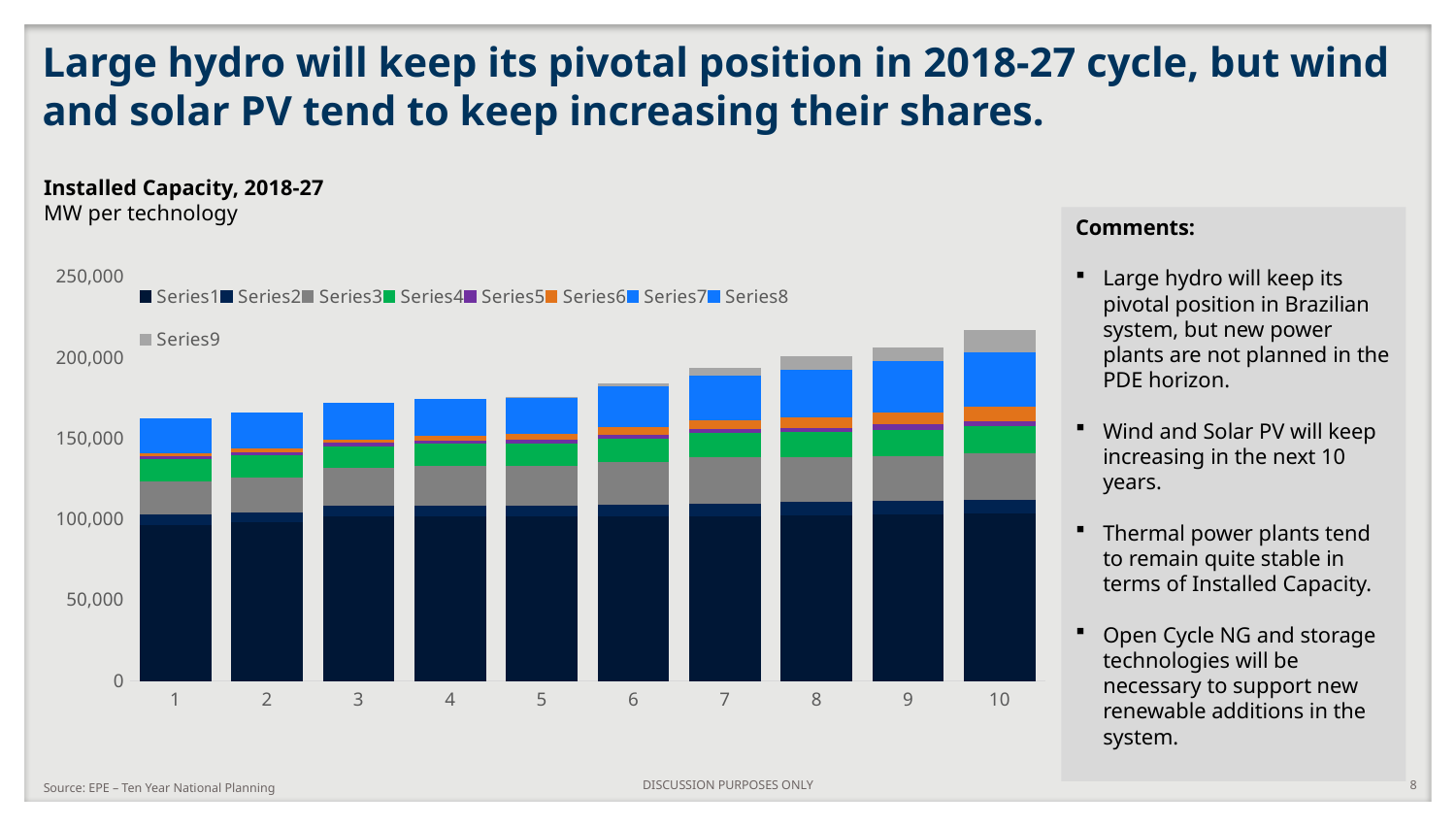
How many categories are shown along the x axis of the chart? 10 Which category has the tallest stacked bar? 10 Which has a taller stacked bar, category 2 or category 8? 8 How many series does the chart's legend list? 9 Do the total bar heights rise or fall from category 1 to category 10? Rise What unit is stated below the chart title? MW per technology Is the total bar height for category 6 greater or less than 150,000? greater What kind of chart is shown on the slide? Stacked bar chart What is the title of the chart? Installed Capacity, 2018-27 Is the total bar height for category 10 greater or less than 200,000? greater Is the total bar height for category 1 greater or less than 200,000? less Which category has the shortest stacked bar? 1